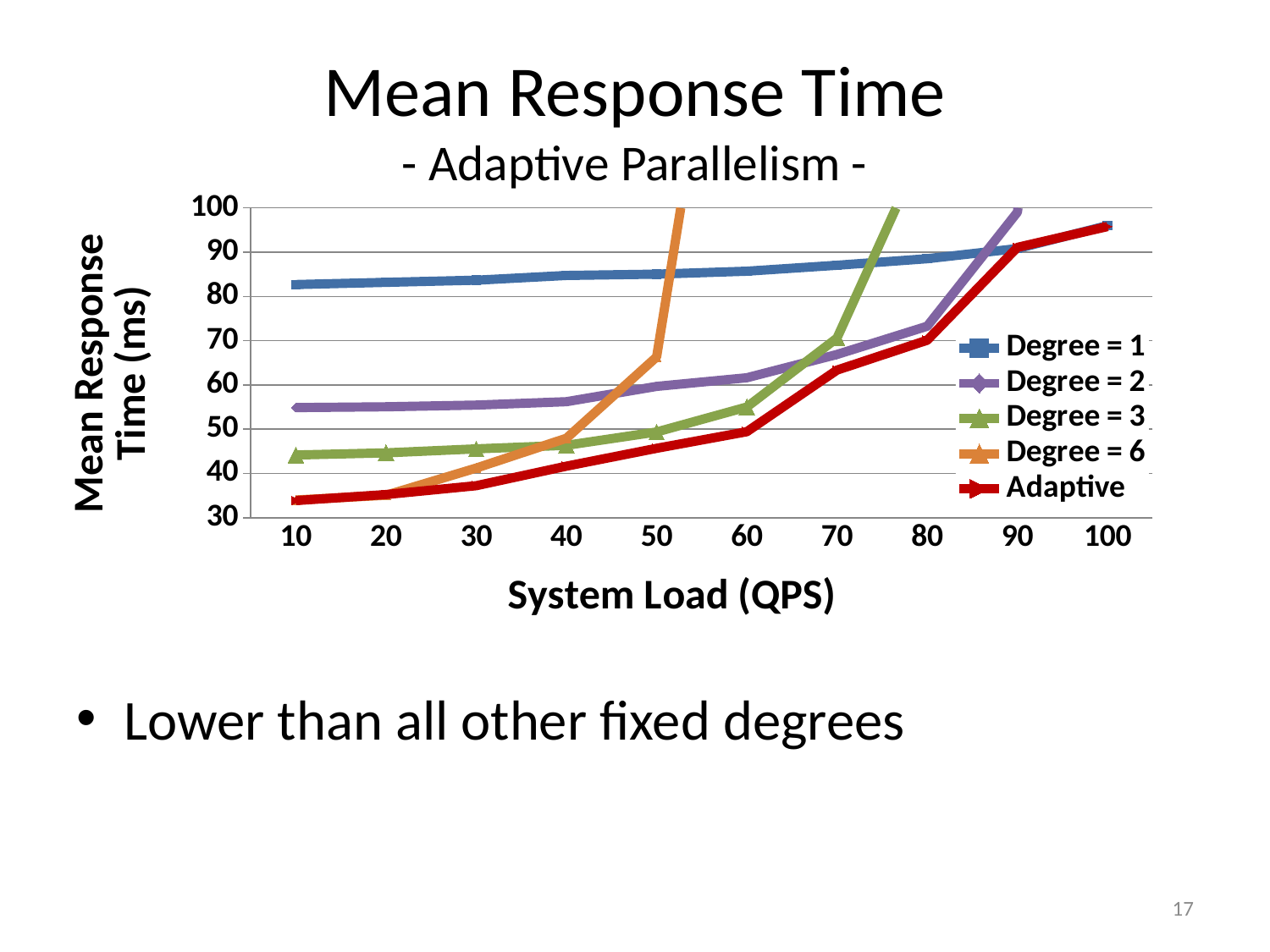
Is the value for Degree = 1 at a system load of 10 QPS greater or less than 80? greater Does the Adaptive series rise or fall as system load increases? rise Is the value for Degree = 6 at a system load of 50 QPS greater or less than 60? greater At a system load of 10 QPS, which series has the highest mean response time? Degree = 1 Is the value for Degree = 3 at a system load of 10 QPS greater or less than 50? less At a system load of 60 QPS, which is larger: the value for Degree = 3 or the value for Adaptive? Degree = 3 How many series does the legend list? 5 How many system load values are marked on the x axis? 10 What kind of chart is shown on the slide? line chart What is the title of the x axis? System Load (QPS)